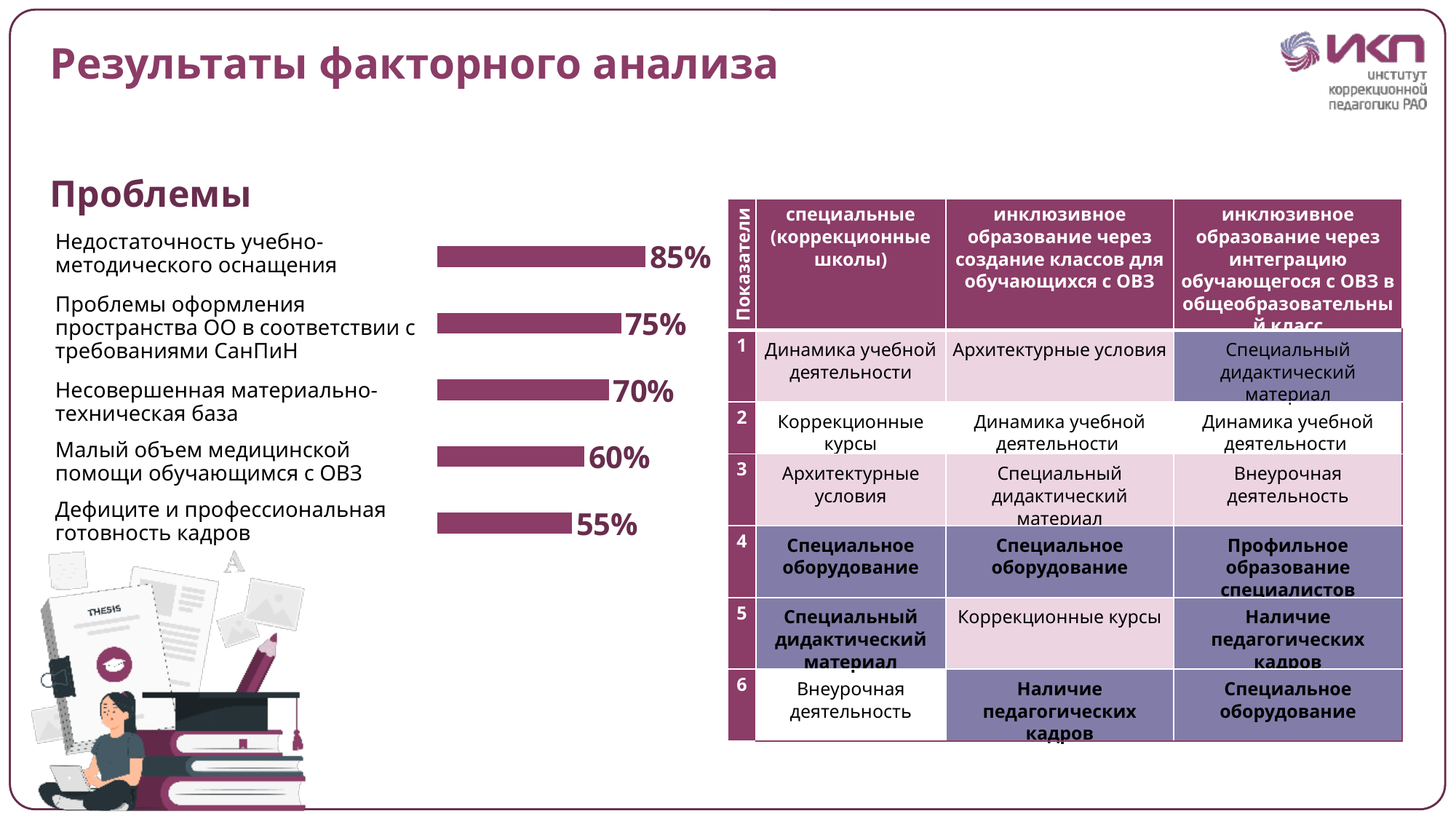
How many problems (bars) are shown in the «Проблемы» bar chart? 5 What value is shown for «Проблемы оформления пространства ОО в соответствии с требованиями СанПиН» in the «Проблемы» bar chart? 75% What value is shown for «Дефиците и профессиональная готовность кадров» in the «Проблемы» bar chart? 55% In the «Проблемы» bar chart, what is the difference between the values for «Проблемы оформления пространства ОО в соответствии с требованиями СанПиН» and «Несовершенная материально-техническая база»? 5% What value is shown for «Недостаточность учебно-методического оснащения» in the «Проблемы» bar chart? 85% In the «Проблемы» bar chart, which is larger: the value for «Несовершенная материально-техническая база» or for «Малый объем медицинской помощи обучающимся с ОВЗ»? Несовершенная материально-техническая база What value is shown for «Малый объем медицинской помощи обучающимся с ОВЗ» in the «Проблемы» bar chart? 60% What type of chart is used under the heading «Проблемы»? Bar chart Which problem has the lowest value in the «Проблемы» bar chart? Дефиците и профессиональная готовность кадров In the «Проблемы» bar chart, what is the difference between the values for «Недостаточность учебно-методического оснащения» and «Дефиците и профессиональная готовность кадров»? 30% What value is shown for «Несовершенная материально-техническая база» in the «Проблемы» bar chart? 70% Which problem has the highest value in the «Проблемы» bar chart? Недостаточность учебно-методического оснащения